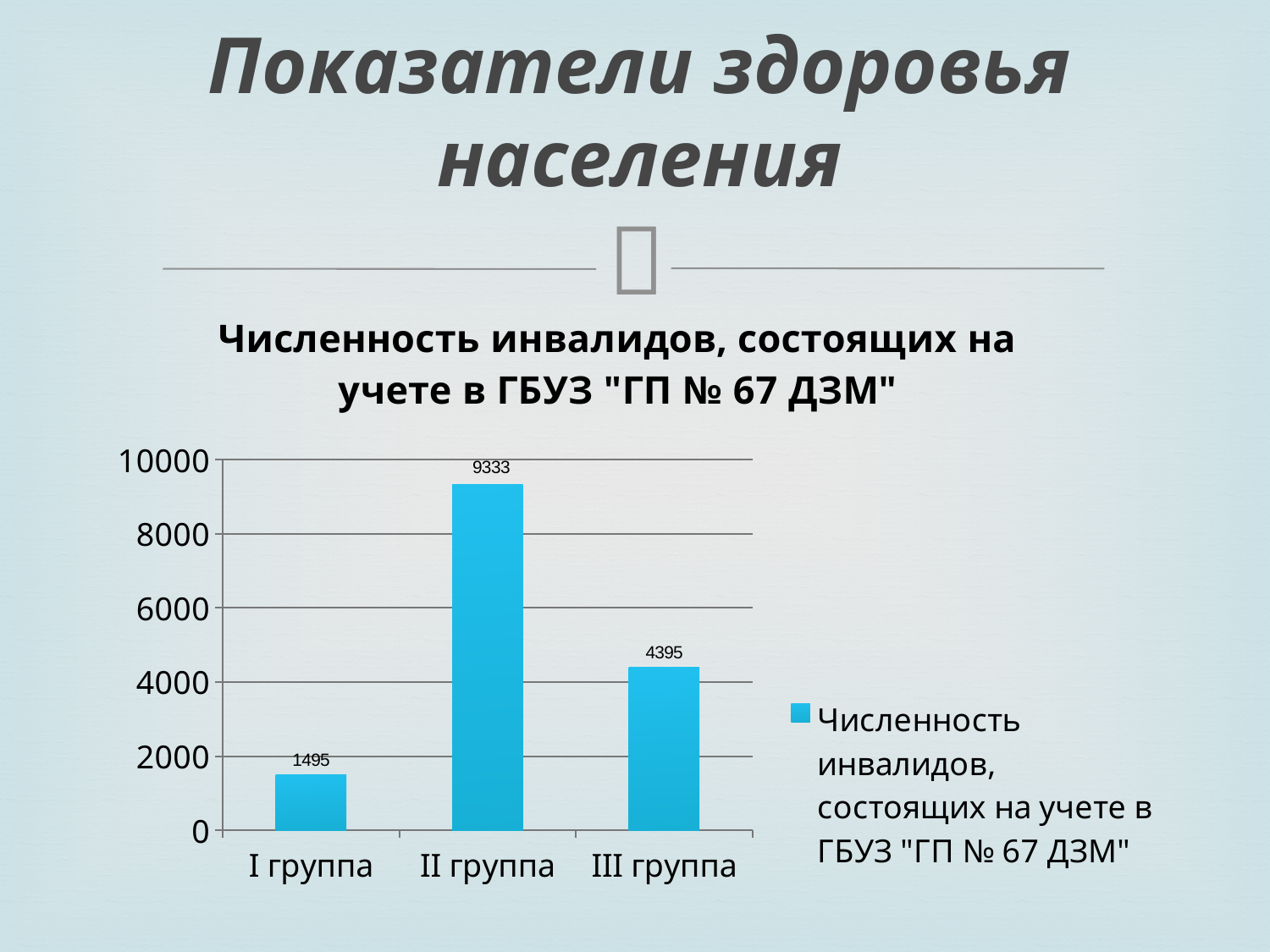
What kind of chart is shown on the slide? bar chart What is the value for II группа? 9333 What is the difference between the values for III группа and I группа? 2900 What is the difference between the values for II группа and III группа? 4938 Which group has the lowest number of registered disabled persons? I группа How many categories are shown on the x axis? 3 What is the title of the chart? Численность инвалидов, состоящих на учете в ГБУЗ "ГП № 67 ДЗМ" Is the value for II группа greater or less than 8000? greater What is the value for III группа? 4395 What is the value for I группа? 1495 Which is larger, the value for I группа or the value for III группа? III группа Which group has the highest number of registered disabled persons? II группа